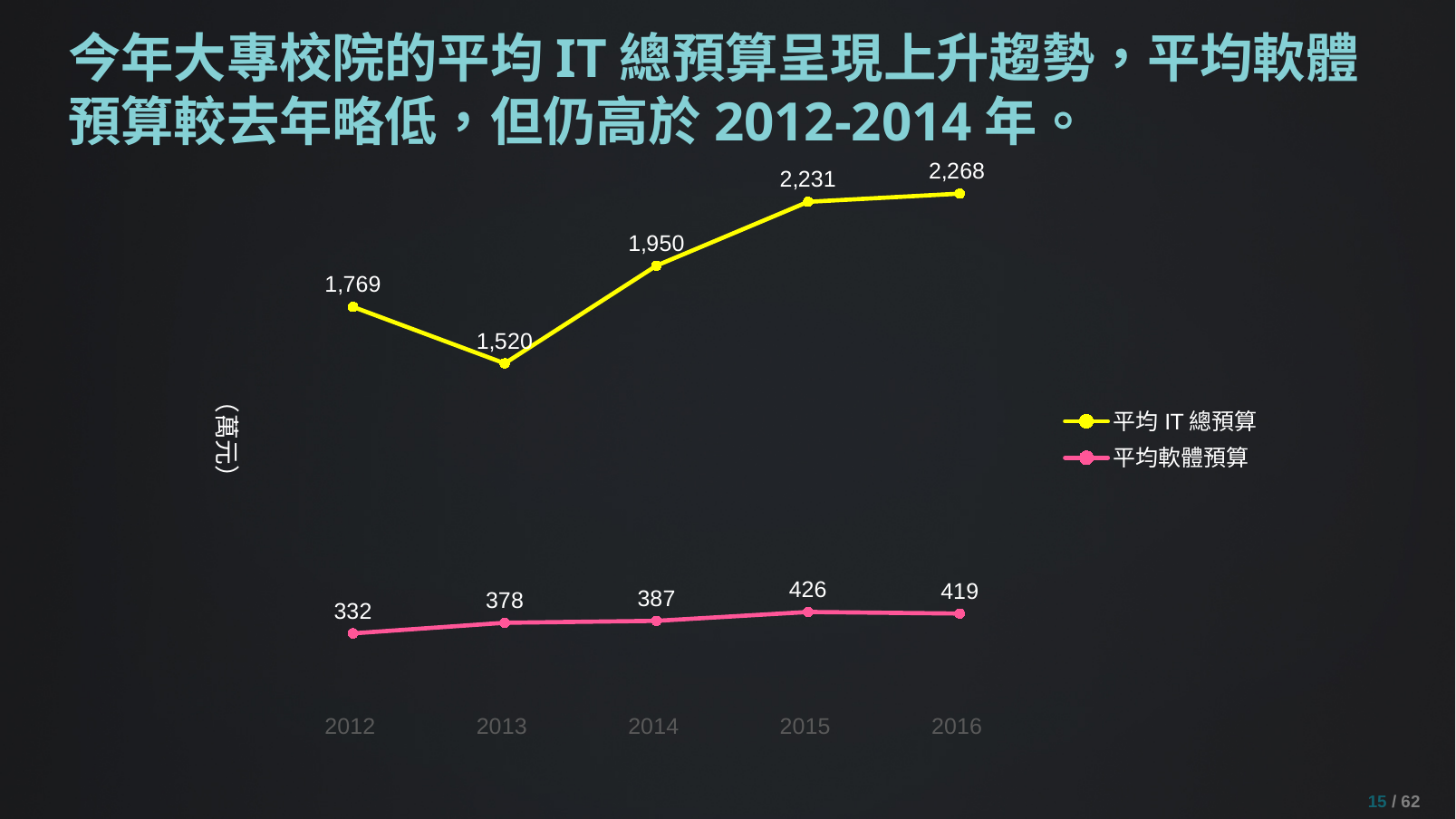
What is the value of 平均 IT 總預算 in 2014? 1,950 What kind of chart is shown on the slide? line chart Which colour is used for the 平均軟體預算 line? pink In which year is 平均軟體預算 the highest? 2015 How many series does the legend list? 2 In which year is 平均 IT 總預算 the lowest? 2013 What is the value of 平均軟體預算 in 2012? 332 What is the value of 平均軟體預算 in 2016? 419 How many years are shown on the x axis? 5 Which is larger: 平均 IT 總預算 in 2012 or in 2013? 2012 What is the difference between 平均 IT 總預算 in 2016 and in 2015? 37 What is the difference between 平均軟體預算 in 2015 and in 2014? 39